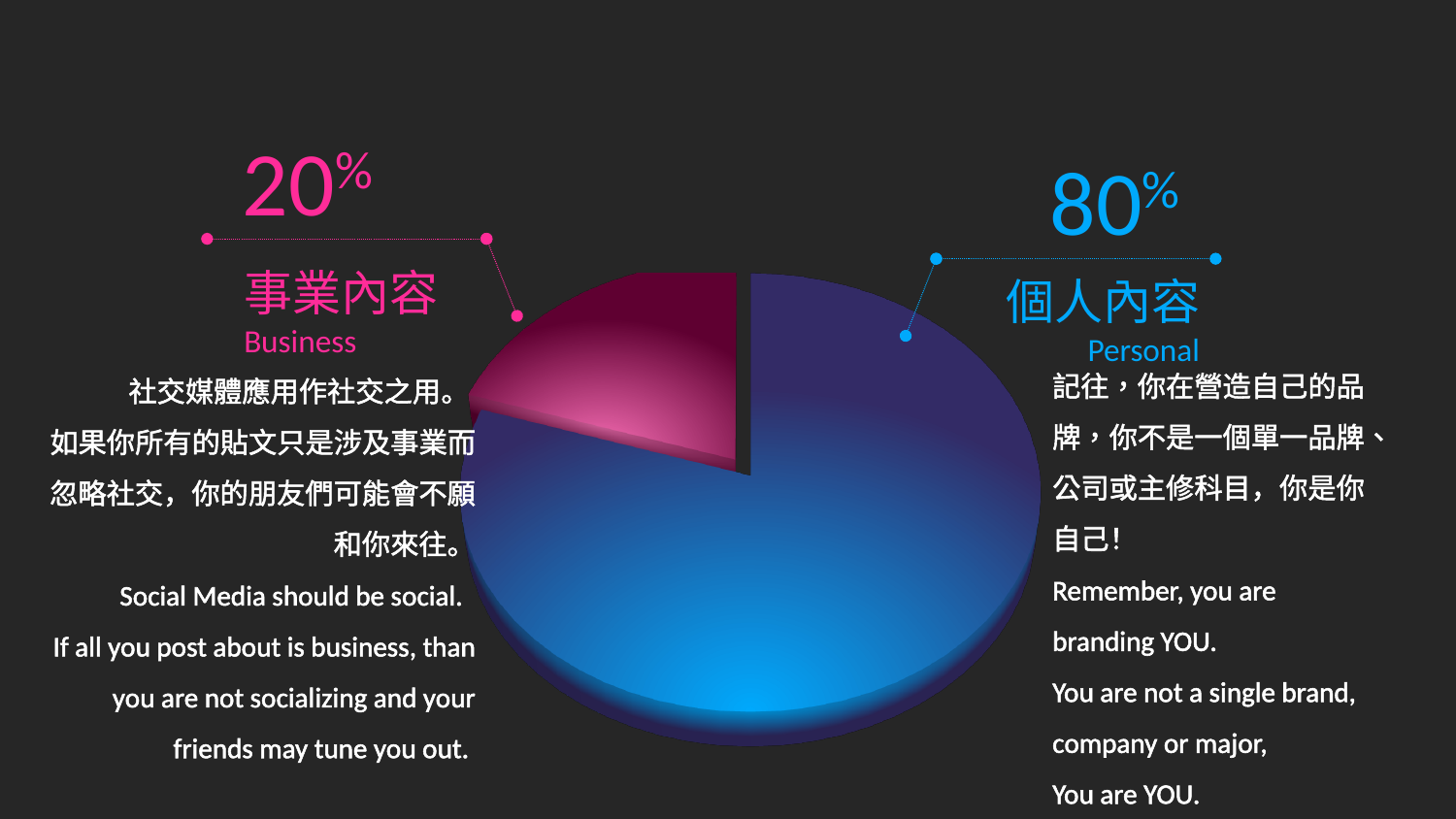
What is the difference in percentage points between the Personal slice and the Business slice? 60 What percentage of the pie is labelled Business (事業內容)? 20% What colour is the Personal (個人內容) slice of the pie chart? Blue What percentage of the pie is labelled Personal (個人內容)? 80% What colour is the Business (事業內容) slice of the pie chart? Pink How many slices does the pie chart have? 2 Which is larger, the Business slice or the Personal slice? Personal What share of the pie does the Business slice represent? 20% Which slice of the pie chart is the largest? Personal (個人內容) Which slice of the pie chart is the smallest? Business (事業內容) What kind of chart is shown on the slide? Pie chart